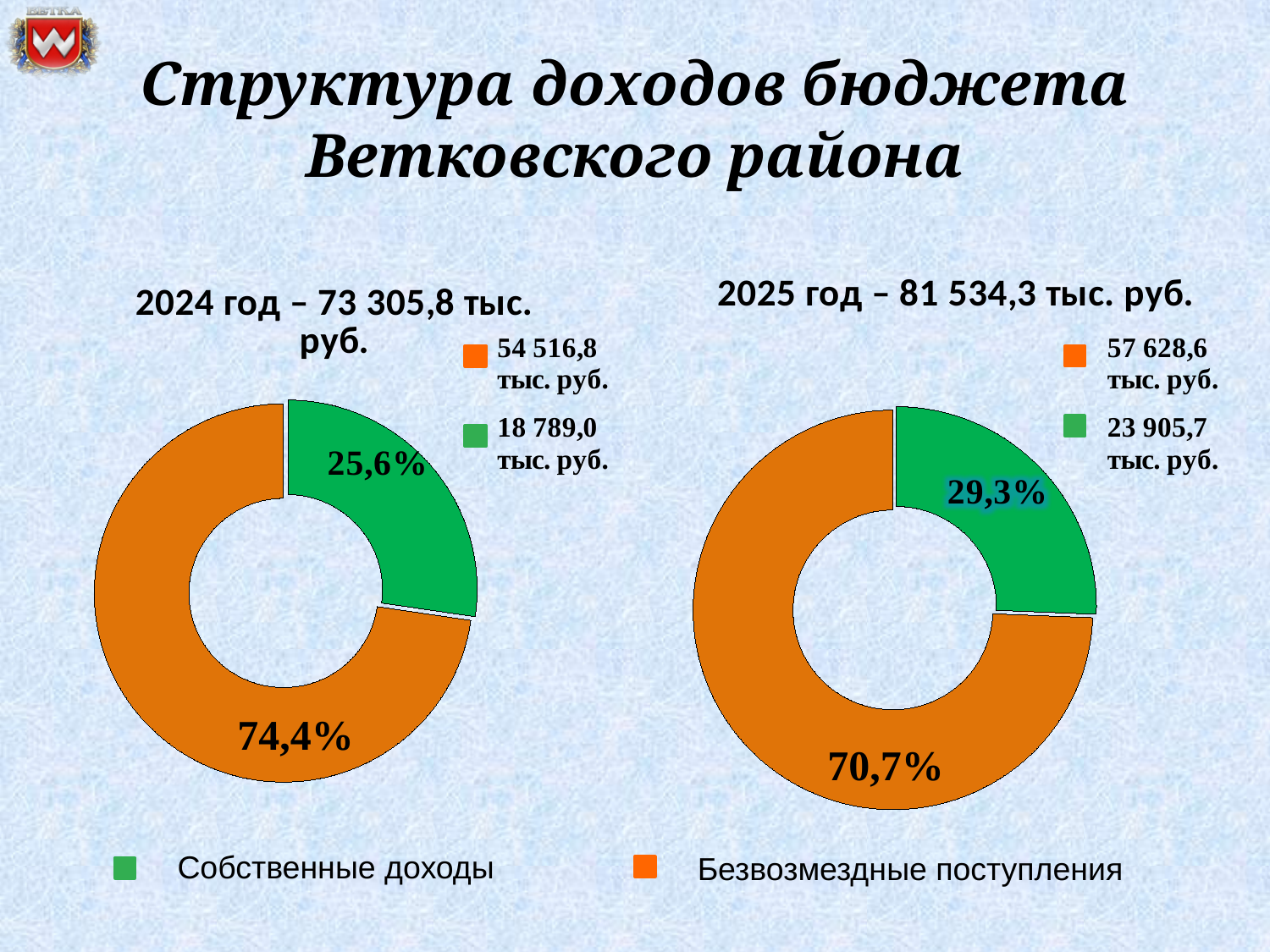
What is the total budget revenue shown for 2025? 81 534,3 тыс. руб. On the 2025 chart, what share of the budget revenue is Безвозмездные поступления? 70,7% On the 2024 chart, what share of the budget revenue is Безвозмездные поступления? 74,4% Which colour represents Собственные доходы on the charts? Green On the 2025 chart, which category has the smaller share? Собственные доходы What type of chart is used on the slide for 2024 and 2025? Donut (pie) chart On the 2024 chart, what share of the budget revenue is Собственные доходы? 25,6% On the 2024 chart, which category has the larger share? Безвозмездные поступления On the 2024 chart, what is the value of Безвозмездные поступления? 54 516,8 тыс. руб. On the 2025 chart, what is the value of Собственные доходы? 23 905,7 тыс. руб. How many categories does each chart on the slide show? 2